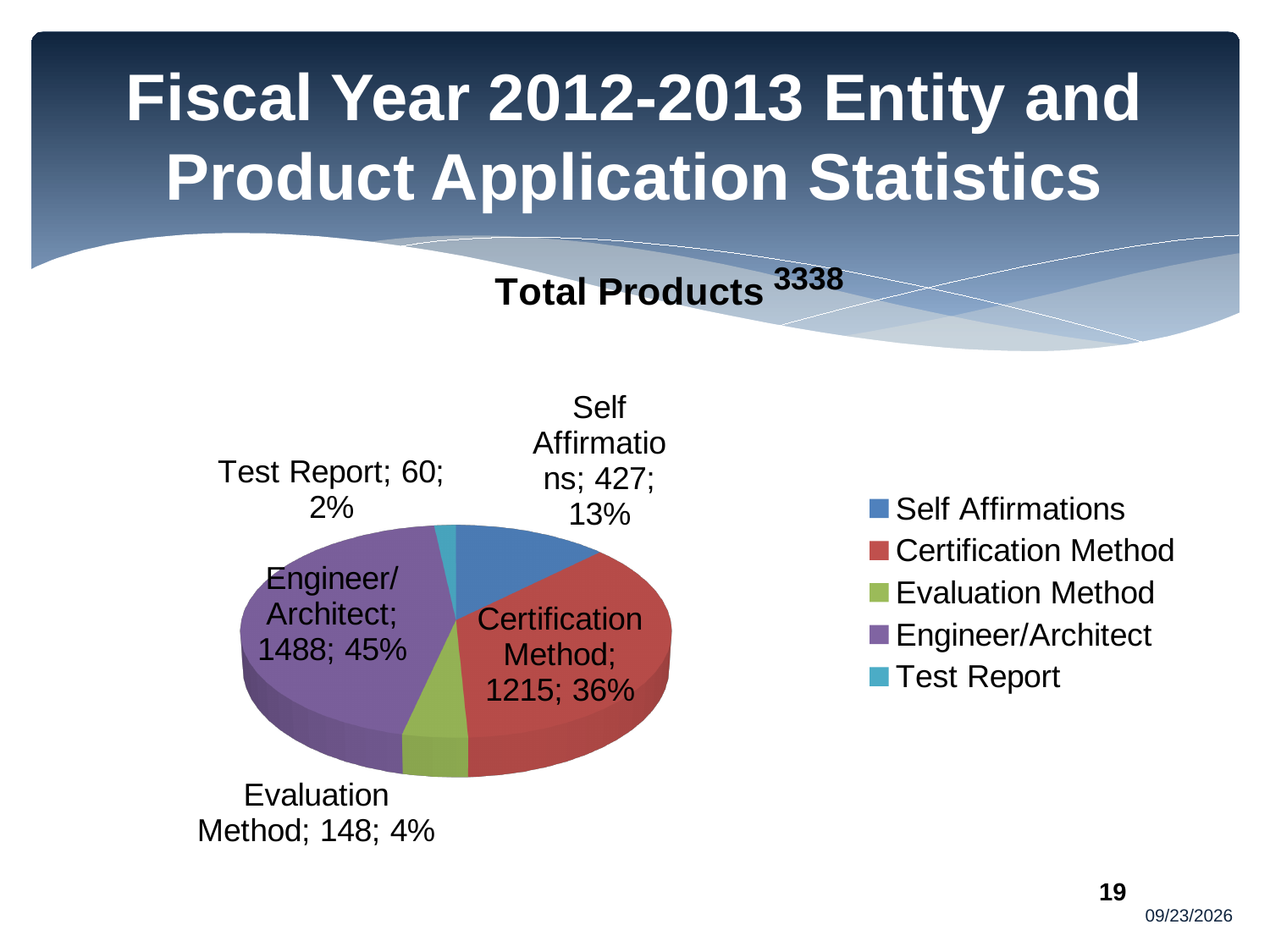
What is the difference between the Engineer/Architect value and the Certification Method value? 273 What kind of chart is shown on the slide? Pie chart What is the total number of products shown above the chart? 3338 What colour is the Evaluation Method slice in the legend? Green What is the value for Self Affirmations? 427 Which is larger, Evaluation Method or Self Affirmations? Self Affirmations What share of the pie does Engineer/Architect represent? 45% How many products are in the Certification Method category? 1215 Which category has the largest slice of the pie? Engineer/Architect What percentage share does Test Report have? 2% How many categories does the pie chart have? 5 Which category has the smallest slice of the pie? Test Report